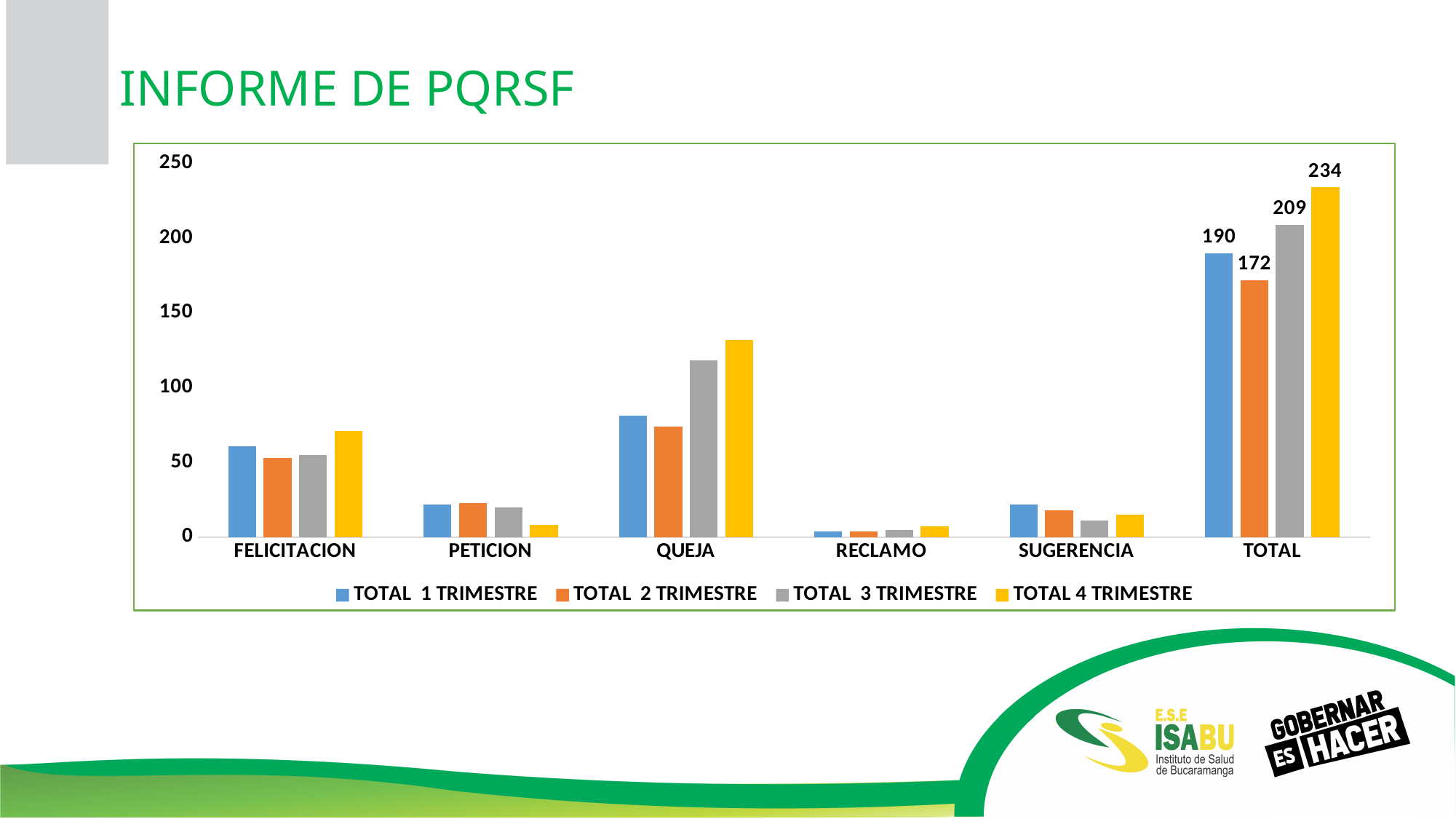
Within the TOTAL category, which series has the highest value? TOTAL 4 TRIMESTRE Is the value of TOTAL 4 TRIMESTRE for QUEJA greater or less than 100? greater What is the value of TOTAL 4 TRIMESTRE for the TOTAL category? 234 What is the difference between TOTAL 4 TRIMESTRE and TOTAL 1 TRIMESTRE in the TOTAL category? 44 What is the difference between TOTAL 3 TRIMESTRE and TOTAL 2 TRIMESTRE in the TOTAL category? 37 What is the value of TOTAL 3 TRIMESTRE for the TOTAL category? 209 Within the TOTAL category, which series has the lowest value? TOTAL 2 TRIMESTRE What is the value of TOTAL 1 TRIMESTRE for the TOTAL category? 190 For TOTAL 1 TRIMESTRE, which is larger: QUEJA or PETICION? QUEJA How many categories are shown on the x axis? 6 How many series does the legend list? 4 Is the value of TOTAL 1 TRIMESTRE for RECLAMO greater or less than 50? less